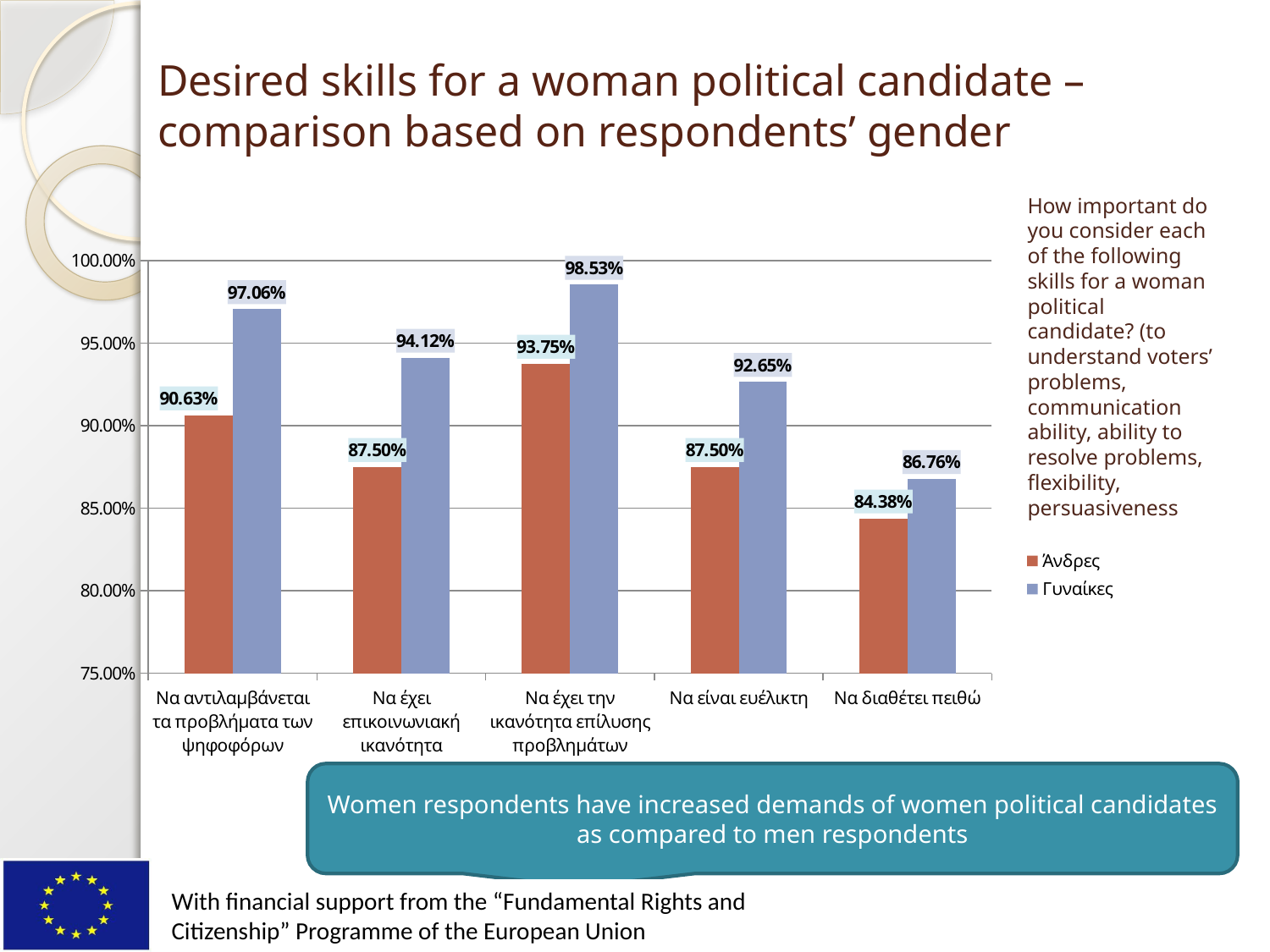
What kind of chart is shown on the slide? bar chart What is the difference between the Γυναίκες and Άνδρες values for 'Να έχει επικοινωνιακή ικανότητα'? 6.62% Which category has the highest value for Γυναίκες? Να έχει την ικανότητα επίλυσης προβλημάτων Is the Γυναίκες value for 'Να διαθέτει πειθώ' greater or less than 90.00%? less How many series does the legend list? 2 What is the value for Άνδρες for 'Να διαθέτει πειθώ'? 84.38% For 'Να είναι ευέλικτη', which series has the larger value, Άνδρες or Γυναίκες? Γυναίκες Which category has the lowest value for Άνδρες? Να διαθέτει πειθώ Which legend entry is shown in blue? Γυναίκες What is the value for Γυναίκες for 'Να έχει την ικανότητα επίλυσης προβλημάτων'? 98.53% How many categories are shown on the x axis? 5 What is the value for Άνδρες for 'Να αντιλαμβάνεται τα προβλήματα των ψηφοφόρων'? 90.63%